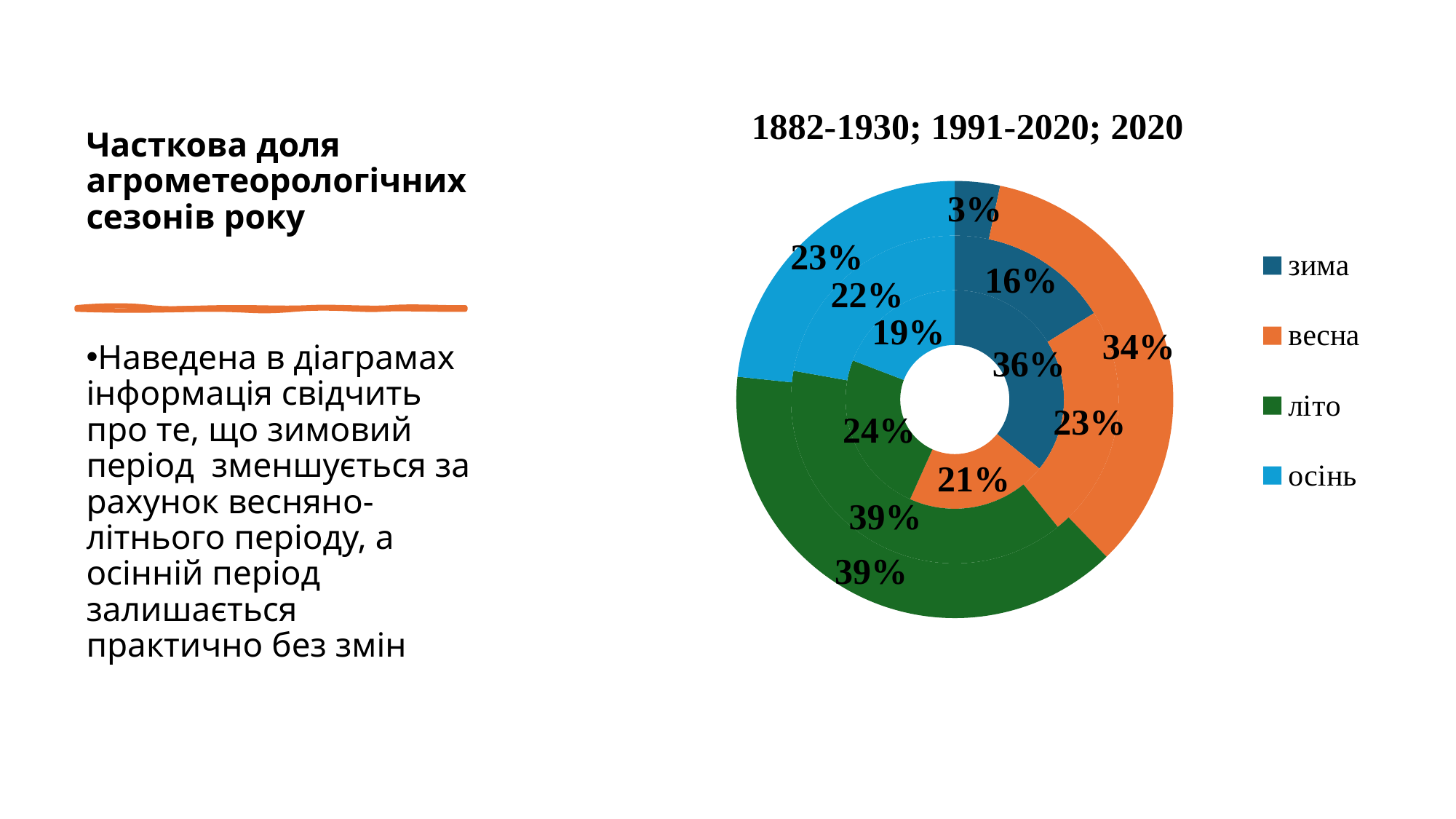
How many entries does the chart legend list? 4 How many rings does the doughnut chart have? 3 What is the share of осінь in the middle ring of the chart? 22% What is the share of весна in the outermost ring of the chart? 34% What kind of chart is shown on the slide? Doughnut chart Which season has the smallest share in the outermost ring? зима What is the share of зима in the innermost ring of the chart? 36% Which season has the largest share in the outermost ring? літо Which season has the largest share in the innermost ring? зима What is the title of the chart? 1882-1930; 1991-2020; 2020 By how many percentage points does the share of зима in the innermost ring exceed its share in the outermost ring? 33 What is the share of літо in the middle ring of the chart? 39%